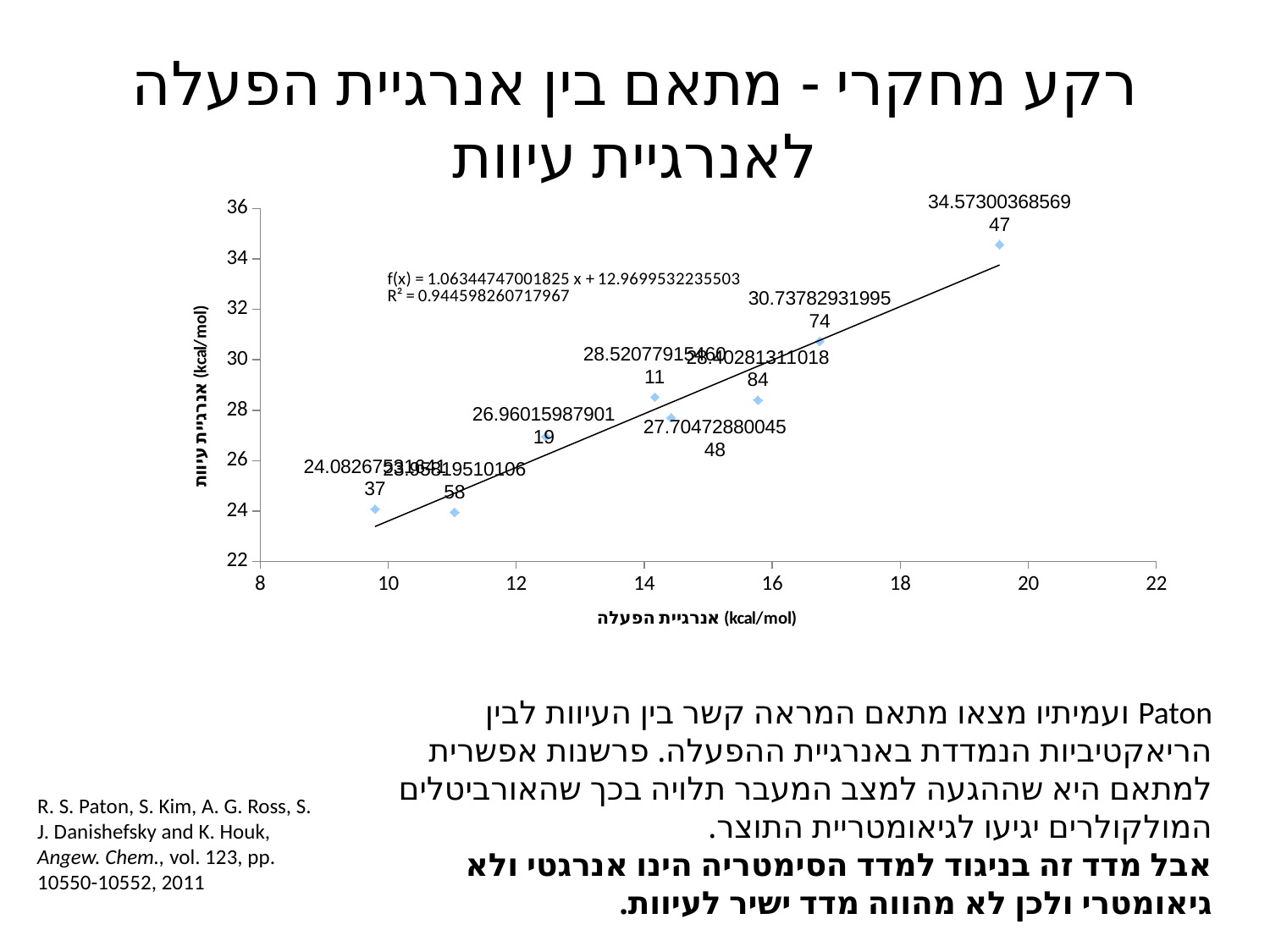
What is the distortion energy value labelled for point 47? 34.57300368569 What is the difference between the distortion energy values of point 47 and point 74? 3.83517436574 Which data point has the highest distortion energy (אנרגיית עיוות) value? 47 What is the distortion energy value labelled for point 74? 30.73782931995 Which has a higher distortion energy value, point 74 or point 84? Point 74 What R² value is shown for the trendline in the chart? 0.944598260717967 What kind of chart is shown on the slide? Scatter chart (with a linear trendline) How many data points are plotted in the chart? 8 What is the distortion energy value labelled for point 48? 27.70472880045 Do the distortion energy values generally rise or fall as activation energy increases along the x axis? Rise What is the distortion energy value labelled for point 19? 26.96015987901 Is the activation energy (x-axis value) for point 47 greater or less than 18? greater